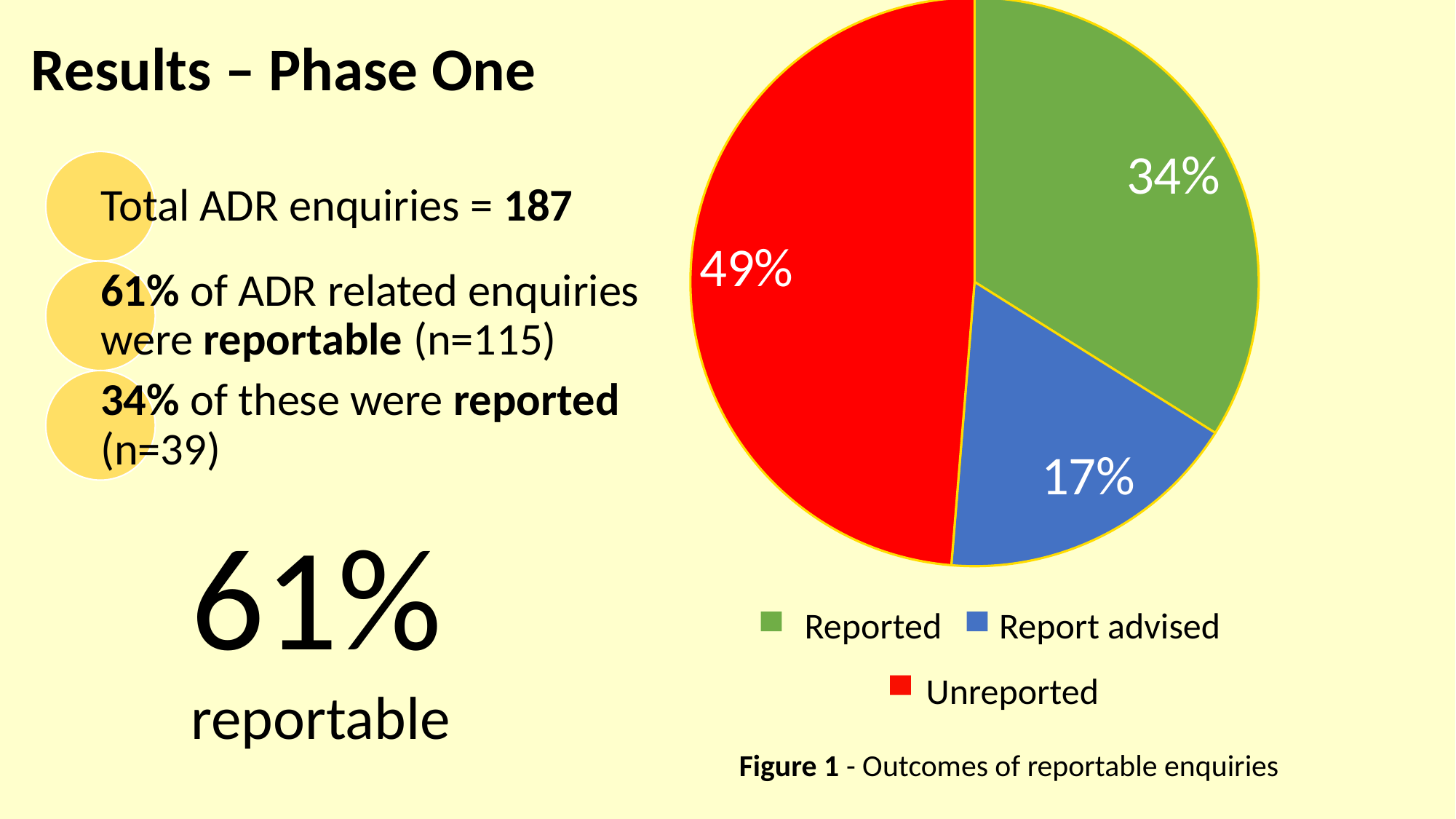
What percentage of reportable enquiries were Reported? 34% What type of chart is shown on the slide? pie chart Which category has the smallest share of the pie? Report advised What is the difference in percentage points between Reported and Report advised? 17 What percentage of reportable enquiries were Unreported? 49% Which category has the largest share of the pie? Unreported How many slices does the pie chart have? 3 What is the difference in percentage points between Unreported and Reported? 15 What percentage of reportable enquiries were Report advised? 17% Which is larger, the Reported share or the Report advised share? Reported What colour represents the Unreported category? red How many entries does the legend list? 3